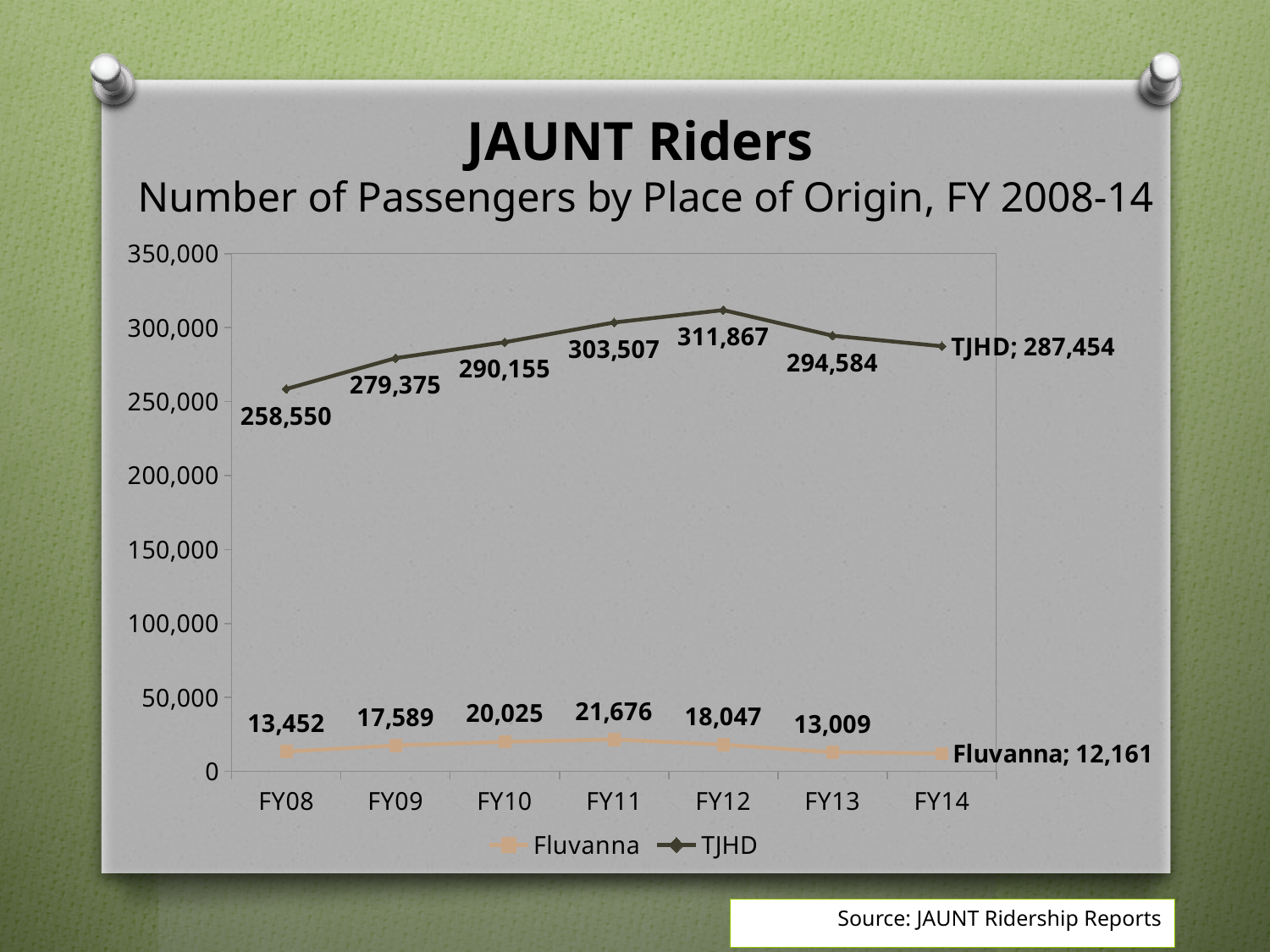
What is the difference between the TJHD values for FY12 and FY14? 24,413 What is the Fluvanna value for FY11? 21,676 What is the Fluvanna value for FY14? 12,161 Is the TJHD value for FY08 greater or less than 250,000? greater How many series does the legend list? 2 In which fiscal year is the TJHD series highest? FY12 What kind of chart is shown on the slide? line chart Does the TJHD series rise or fall from FY12 to FY14? fall What is the TJHD value for FY12? 311,867 How many fiscal years are shown on the x axis? 7 In which fiscal year is the Fluvanna series lowest? FY14 Which is larger, the Fluvanna value for FY09 or for FY13? FY09